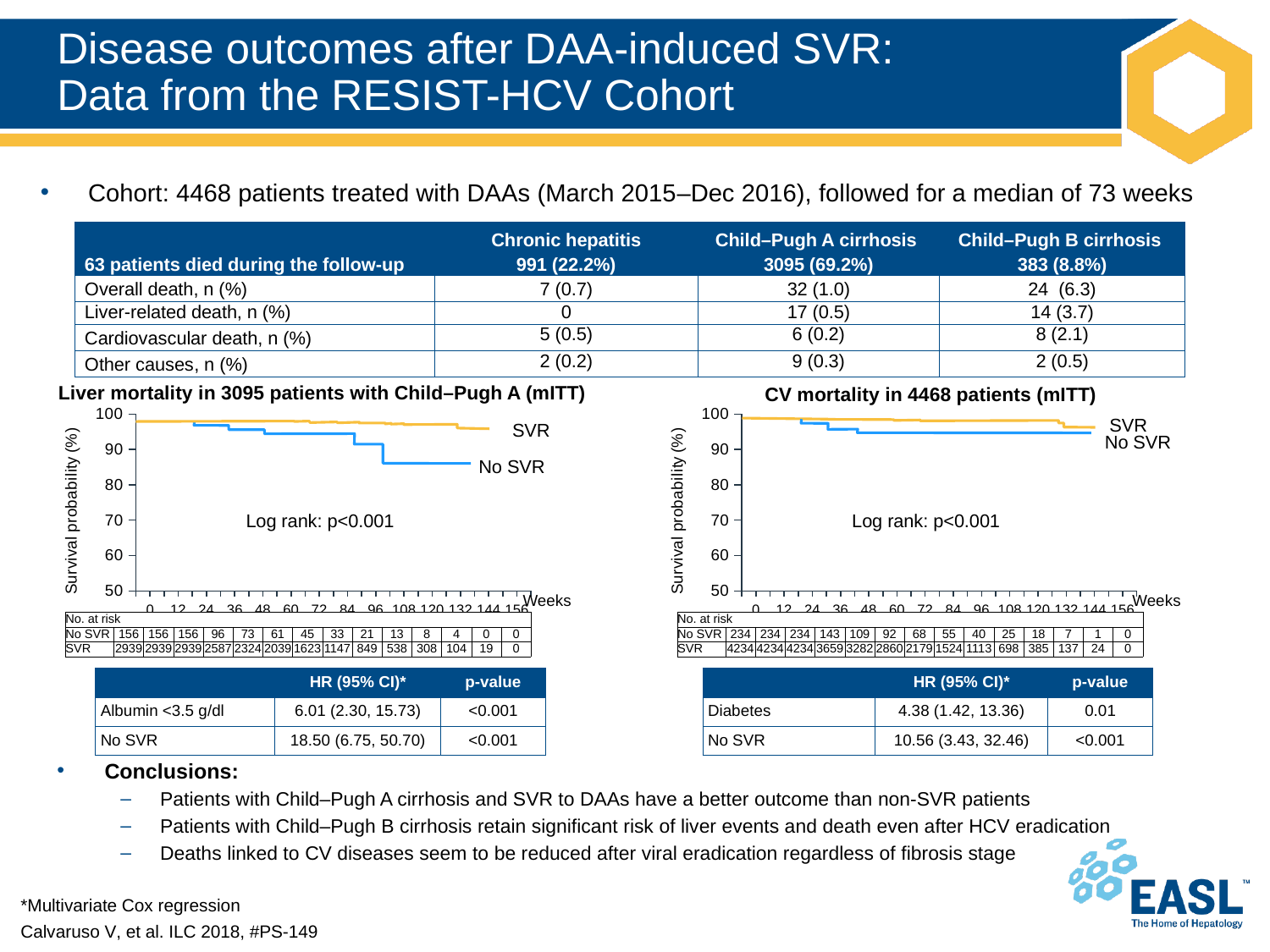
In the right chart 'CV mortality in 4468 patients (mITT)', does the survival probability of the No SVR group rise or fall as weeks increase? fall In the left chart 'Liver mortality in 3095 patients with Child–Pugh A (mITT)', how many No SVR patients are at risk at week 0 according to the 'No. at risk' table? 156 In the left chart 'Liver mortality in 3095 patients with Child–Pugh A (mITT)', how many SVR patients are at risk at week 0 according to the 'No. at risk' table? 2939 In the left chart 'Liver mortality in 3095 patients with Child–Pugh A (mITT)', is the survival probability of the SVR group at week 120 greater or less than 90? greater What kind of chart is the left chart titled 'Liver mortality in 3095 patients with Child–Pugh A (mITT)'? Line chart (survival curve) In the left chart 'Liver mortality in 3095 patients with Child–Pugh A (mITT)', is the survival probability of the No SVR group at week 120 greater or less than 90? less In the left chart 'Liver mortality in 3095 patients with Child–Pugh A (mITT)', which series has the higher survival probability at week 120, SVR or No SVR? SVR In the right chart 'CV mortality in 4468 patients (mITT)', is the survival probability of the No SVR group at week 120 greater or less than 90? greater How many series are plotted in the left chart 'Liver mortality in 3095 patients with Child–Pugh A (mITT)'? 2 In the left chart 'Liver mortality in 3095 patients with Child–Pugh A (mITT)', what is the log rank p-value shown? p<0.001 In the right chart 'CV mortality in 4468 patients (mITT)', how many SVR patients are at risk at week 0 according to the 'No. at risk' table? 4234 In the right chart 'CV mortality in 4468 patients (mITT)', how many No SVR patients are at risk at week 0 according to the 'No. at risk' table? 234